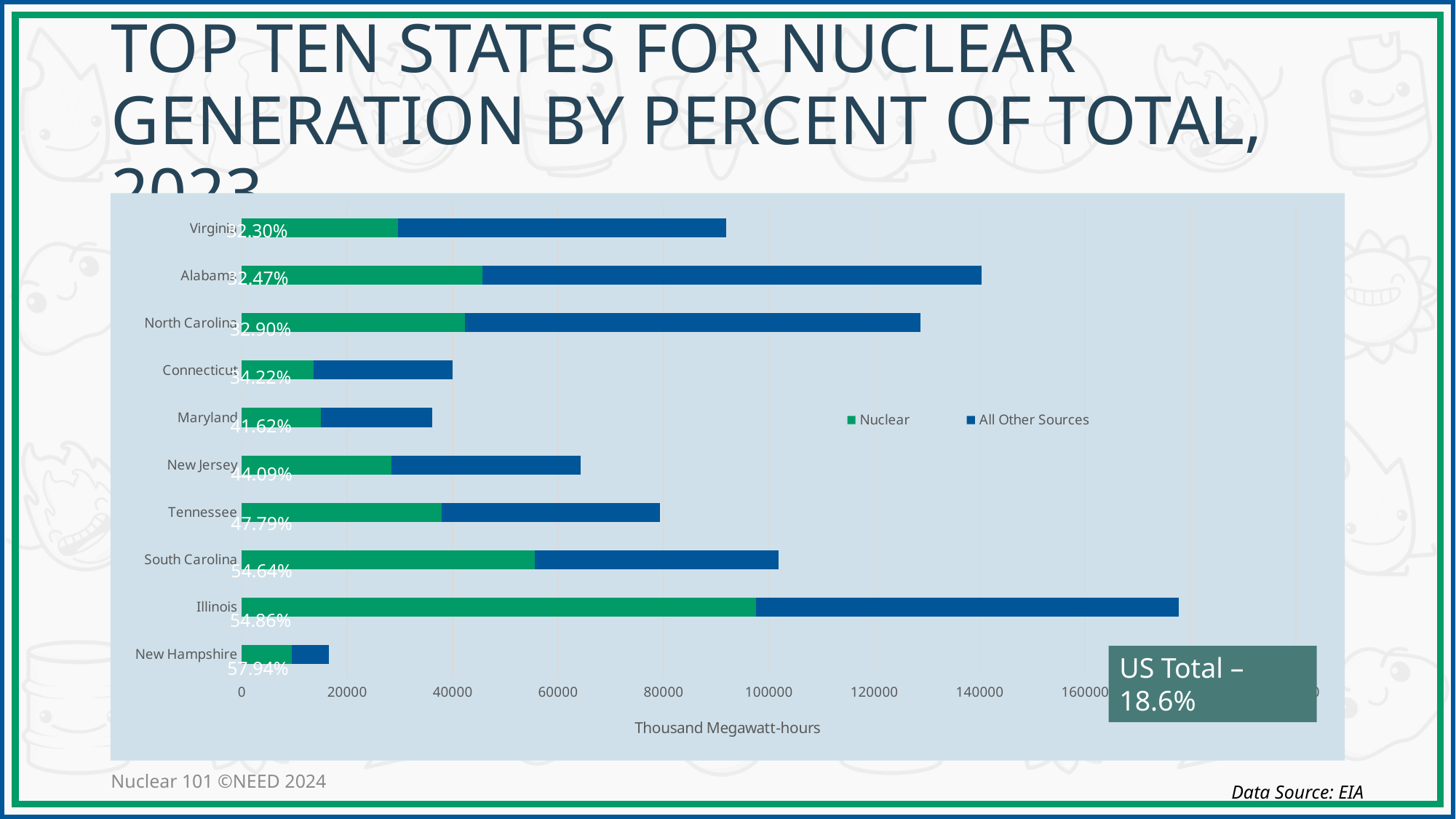
What nuclear percentage is labeled for Illinois? 54.86% How many states are shown in the chart? 10 Which state has the shortest total bar (smallest total generation)? New Hampshire Which state has a longer total bar, Alabama or Virginia? Alabama How many series does the legend list? 2 Which state has the longest total bar (largest total generation)? Illinois What is the x-axis title of the chart? Thousand Megawatt-hours What nuclear percentage is labeled for Virginia? 32.30% What type of chart is shown on the slide? Stacked bar chart Is the total bar for Illinois greater or less than 160000 thousand megawatt-hours? greater Is the total bar for Connecticut greater or less than 60000 thousand megawatt-hours? less What nuclear percentage is labeled for New Hampshire? 57.94%